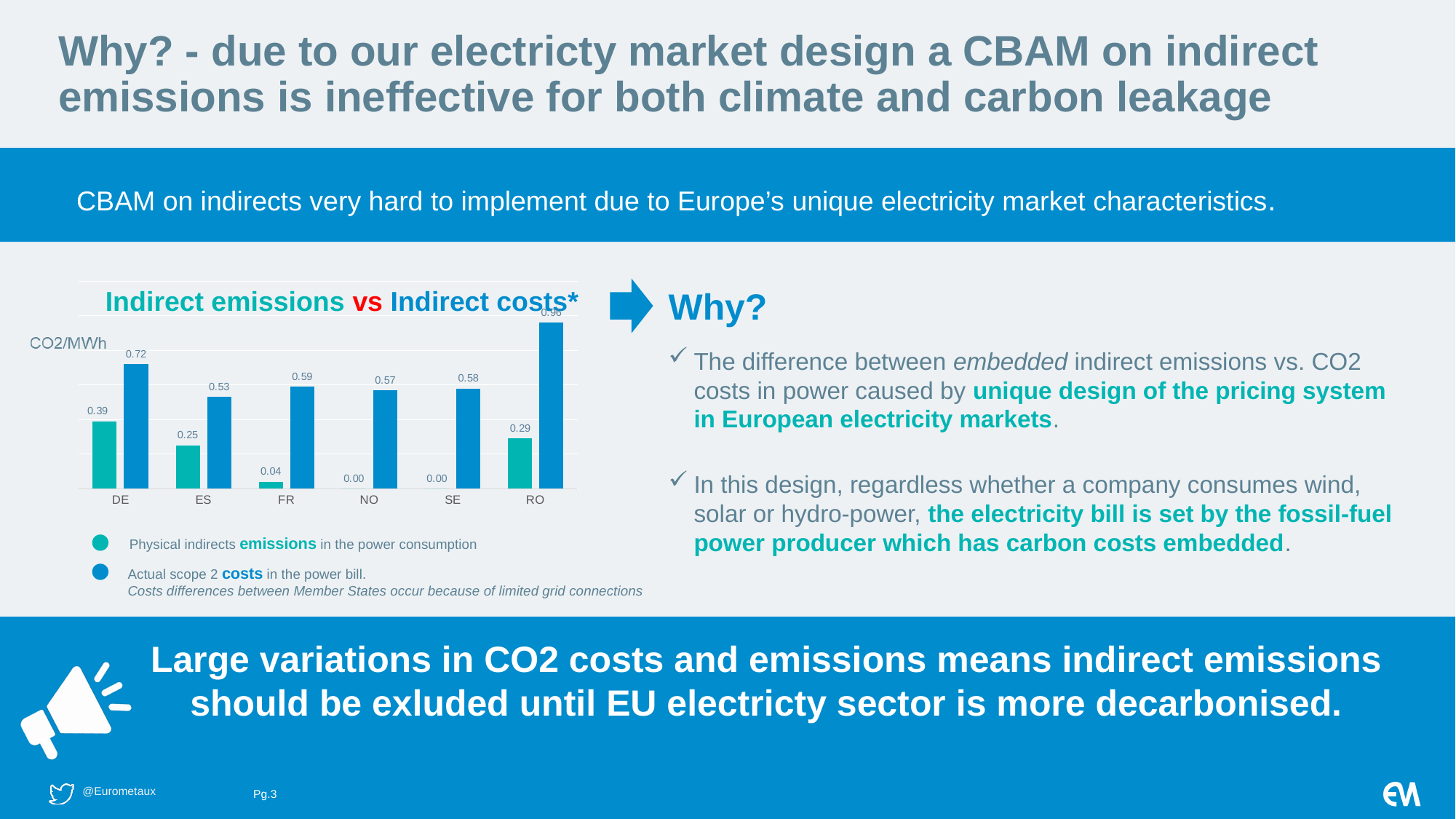
In the 'Indirect emissions vs Indirect costs*' chart, what is the physical indirect emissions value for NO? 0.00 In the 'Indirect emissions vs Indirect costs*' chart, which country has the highest actual scope 2 costs value? RO In the 'Indirect emissions vs Indirect costs*' chart, which country has the highest physical indirect emissions value? DE In the 'Indirect emissions vs Indirect costs*' chart, which country has the lowest actual scope 2 costs value? ES In the 'Indirect emissions vs Indirect costs*' chart, which has the larger physical indirect emissions value, ES or RO? RO In the 'Indirect emissions vs Indirect costs*' chart, what is the difference between the actual scope 2 costs and the physical indirect emissions for DE? 0.33 In the 'Indirect emissions vs Indirect costs*' chart, what is the actual scope 2 cost value for FR? 0.59 What type of chart is 'Indirect emissions vs Indirect costs*'? Bar chart How many series does the legend of the 'Indirect emissions vs Indirect costs*' chart list? 2 In the 'Indirect emissions vs Indirect costs*' chart, what is the value of physical indirect emissions for DE? 0.39 In the 'Indirect emissions vs Indirect costs*' chart, what is the physical indirect emissions value for ES? 0.25 How many countries are shown on the x axis of the 'Indirect emissions vs Indirect costs*' chart? 6